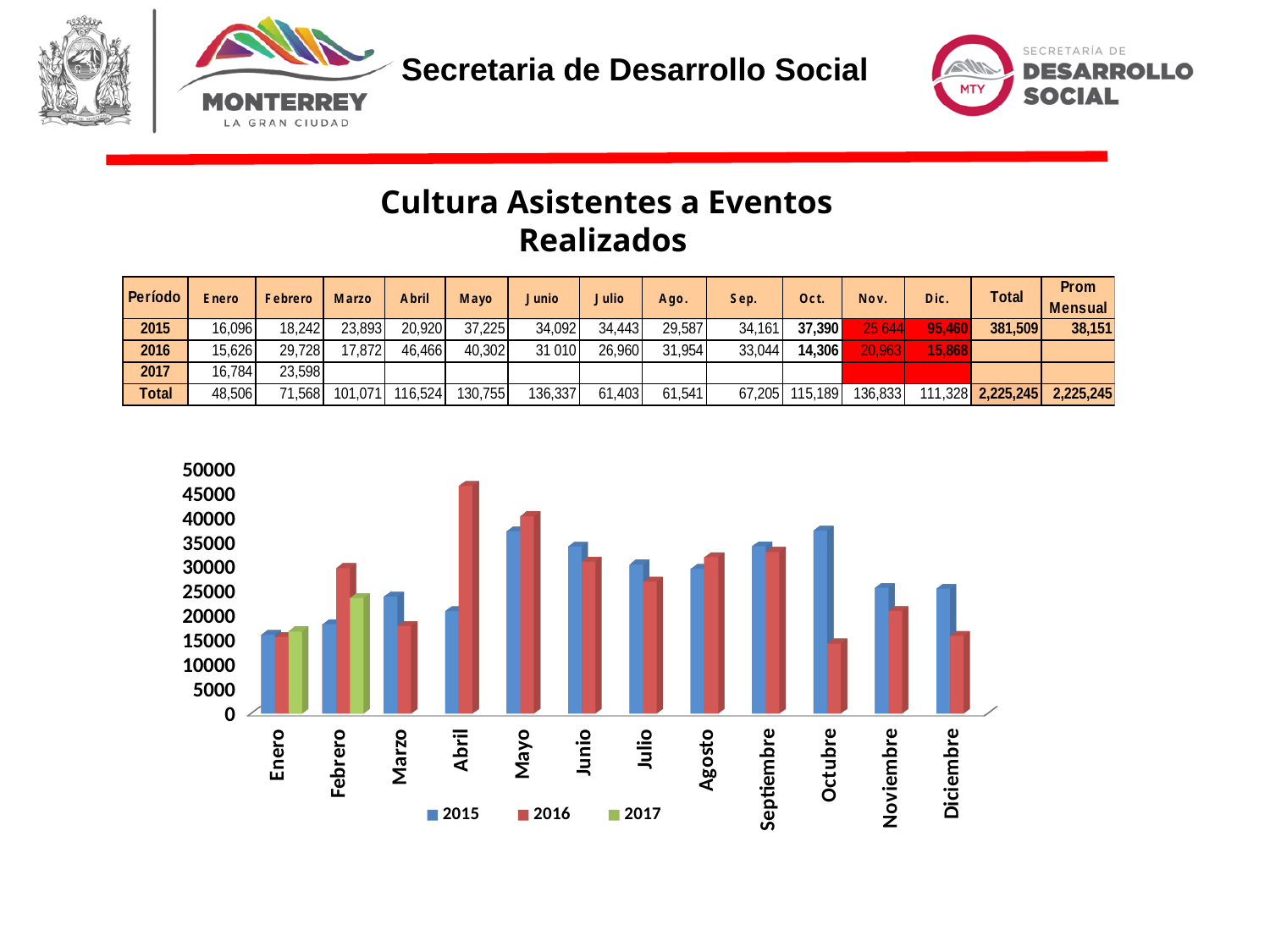
Is the 2015 value for Mayo in the chart greater or less than 35000? greater According to the table, what is the difference between the 2016 and 2015 values for Abril? 25,546 In the chart, for Abril, which series is larger: 2015 or 2016? 2016 What kind of chart is shown on the slide? bar chart How many months are shown along the x axis of the chart? 12 According to the table, what is the value for Enero in 2015? 16,096 Is the 2016 value for Octubre in the chart greater or less than 20000? less What colour represents the 2017 series in the chart? green For how many months does the chart show a bar for the 2017 series? 2 In the chart, which month has the lowest value for the 2016 series? Octubre How many series does the chart legend list? 3 In the chart, which month has the highest value for the 2016 series? Abril